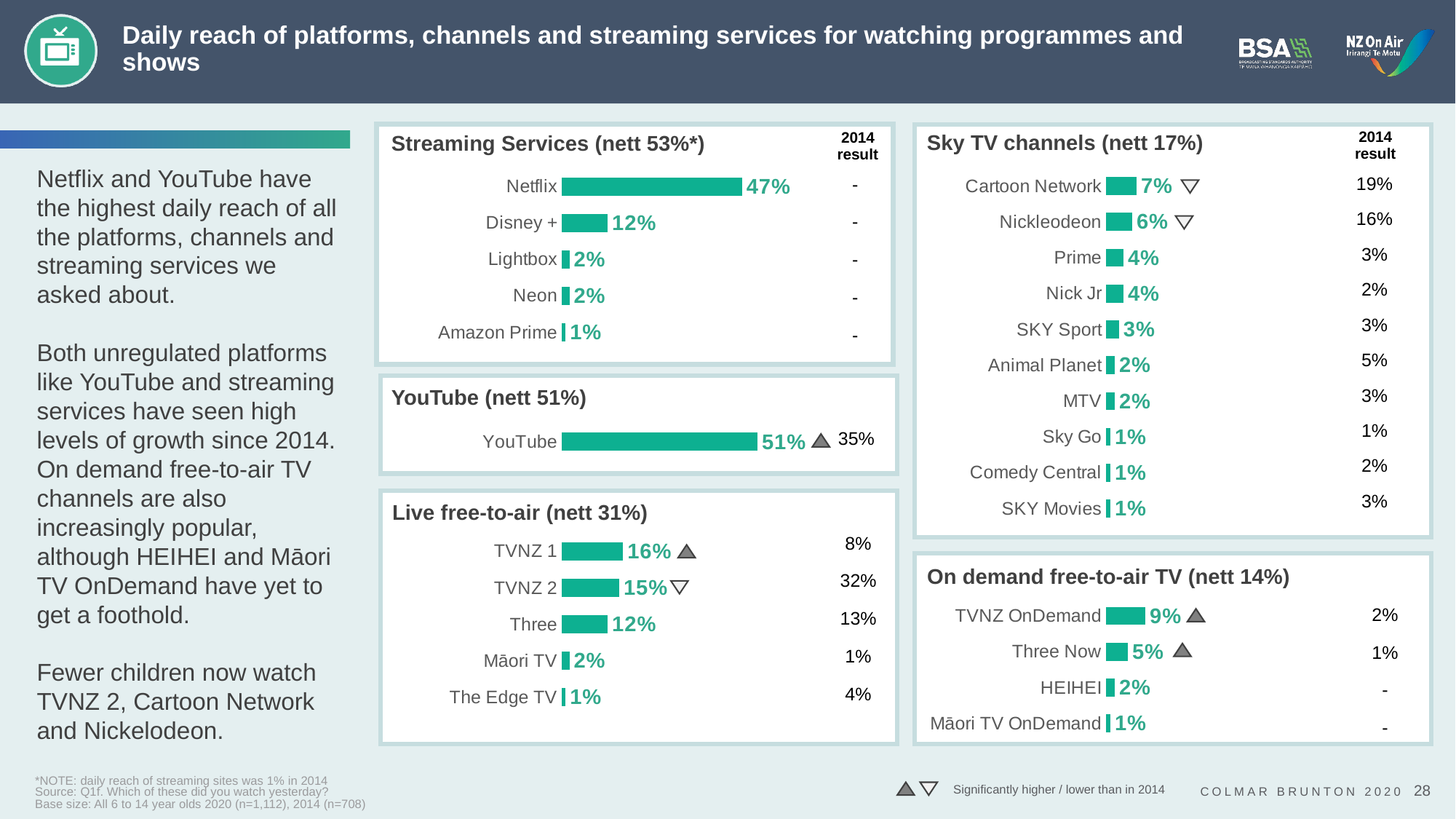
In the Sky TV channels chart, what is the 2014 result for Nickleodeon? 16% What type of chart is used in the Streaming Services panel? Bar chart In the On demand free-to-air TV chart, what is the daily reach value for Three Now? 5% In the Live free-to-air chart, which is larger, the value for Three or the value for Māori TV? Three In the Streaming Services chart, which streaming service has the lowest daily reach? Amazon Prime In the Streaming Services chart, how many streaming services are plotted? 5 In the Streaming Services chart, what is the daily reach value for Netflix? 47% In the Sky TV channels chart, which channel has the highest daily reach? Cartoon Network In the Sky TV channels chart, what is the difference between the Cartoon Network value and the Prime value? 3% In the YouTube chart, what was the 2014 result for YouTube? 35% In the Sky TV channels chart, how many channels are plotted? 10 In the Live free-to-air chart, what is the daily reach value for TVNZ 2? 15%